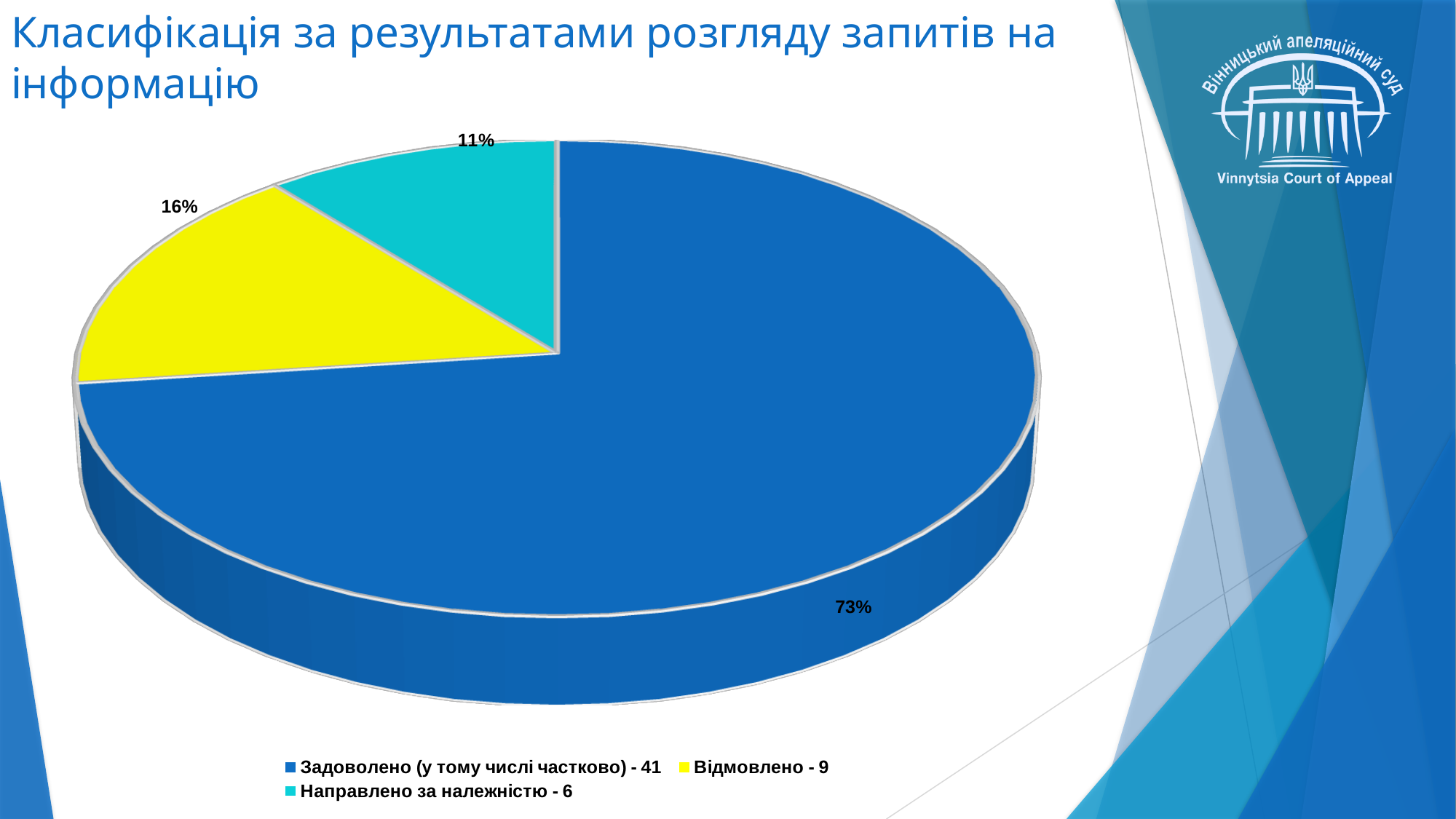
Which category has the largest slice of the pie? Задоволено (у тому числі частково) - 41 What is the difference in percentage points between the "Задоволено (у тому числі частково)" slice and the "Відмовлено" slice? 57 What kind of chart is shown on the slide? Pie chart What percentage share does the slice for "Направлено за належністю - 6" have? 11% Which slice is larger: "Відмовлено - 9" or "Направлено за належністю - 6"? Відмовлено - 9 What colour is the slice for "Відмовлено - 9"? Yellow What percentage share does the slice for "Відмовлено - 9" have? 16% How many slices does the pie chart have? 3 What is the difference in percentage points between the "Відмовлено" slice and the "Направлено за належністю" slice? 5 Which category has the smallest slice of the pie? Направлено за належністю - 6 What is the title of the slide containing the pie chart? Класифікація за результатами розгляду запитів на інформацію What percentage share does the slice for "Задоволено (у тому числі частково) - 41" have? 73%